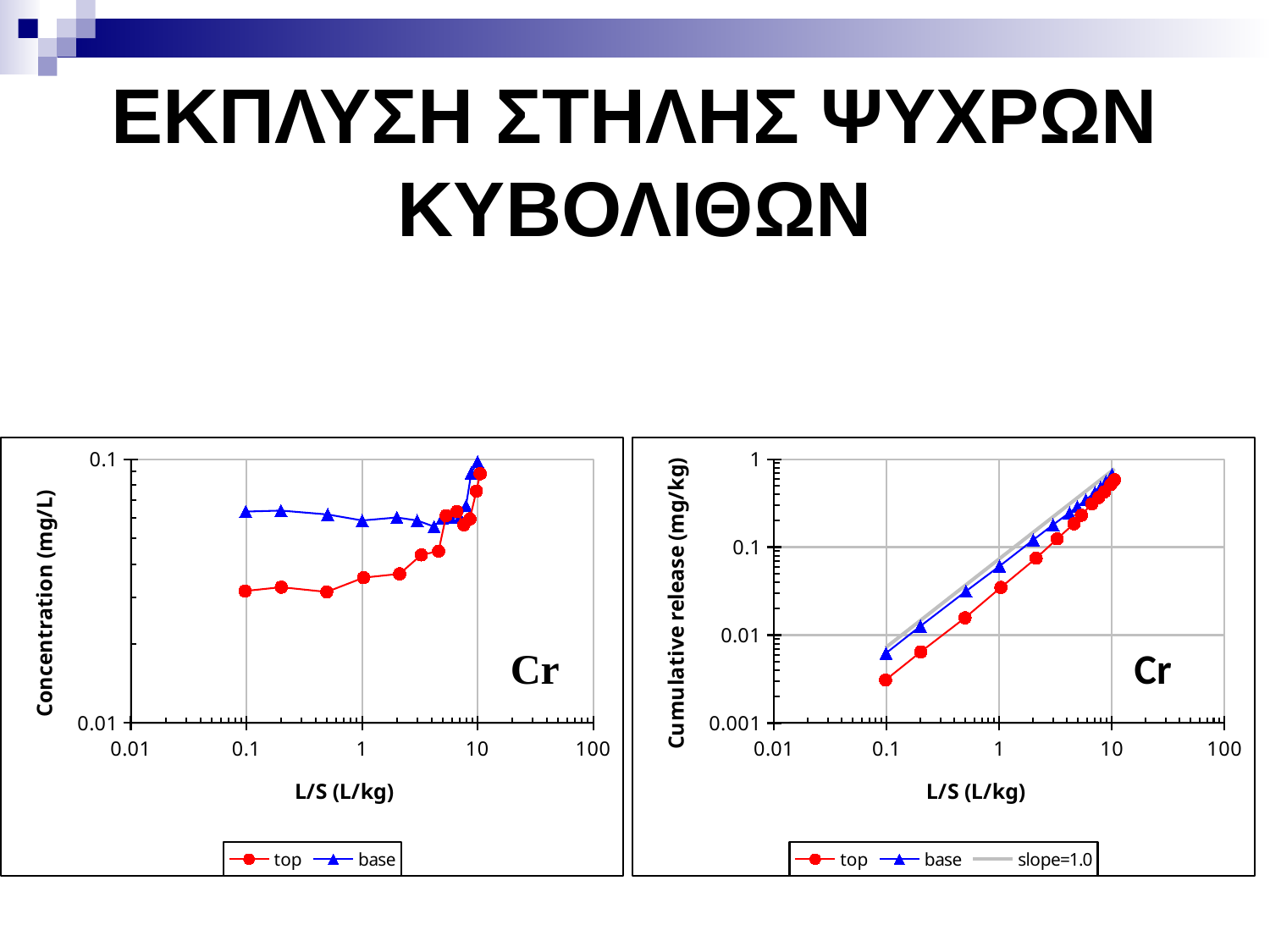
How many series does the legend of the right chart (Cumulative release) list? 3 In the right chart (Cumulative release), is the value for the top series at L/S = 0.1 greater or less than 0.01? less In the left chart (Concentration), at L/S = 0.1, which series has the higher value, top or base? base In the right chart (Cumulative release), do the values of the top series rise or fall as L/S increases? rise In the right chart (Cumulative release), at L/S = 0.1, which series has the higher value, top or base? base In the left chart (Concentration), is the value for the base series at L/S = 1 greater or less than 0.01? greater What is the third legend entry in the right chart (Cumulative release)? slope=1.0 What is the x-axis label of the left chart? L/S (L/kg) In the right chart (Cumulative release), is the value for the base series at L/S = 10 greater or less than 0.1? greater What kind of chart is the left chart (Concentration vs L/S)? line chart How many series does the legend of the left chart (Concentration) list? 2